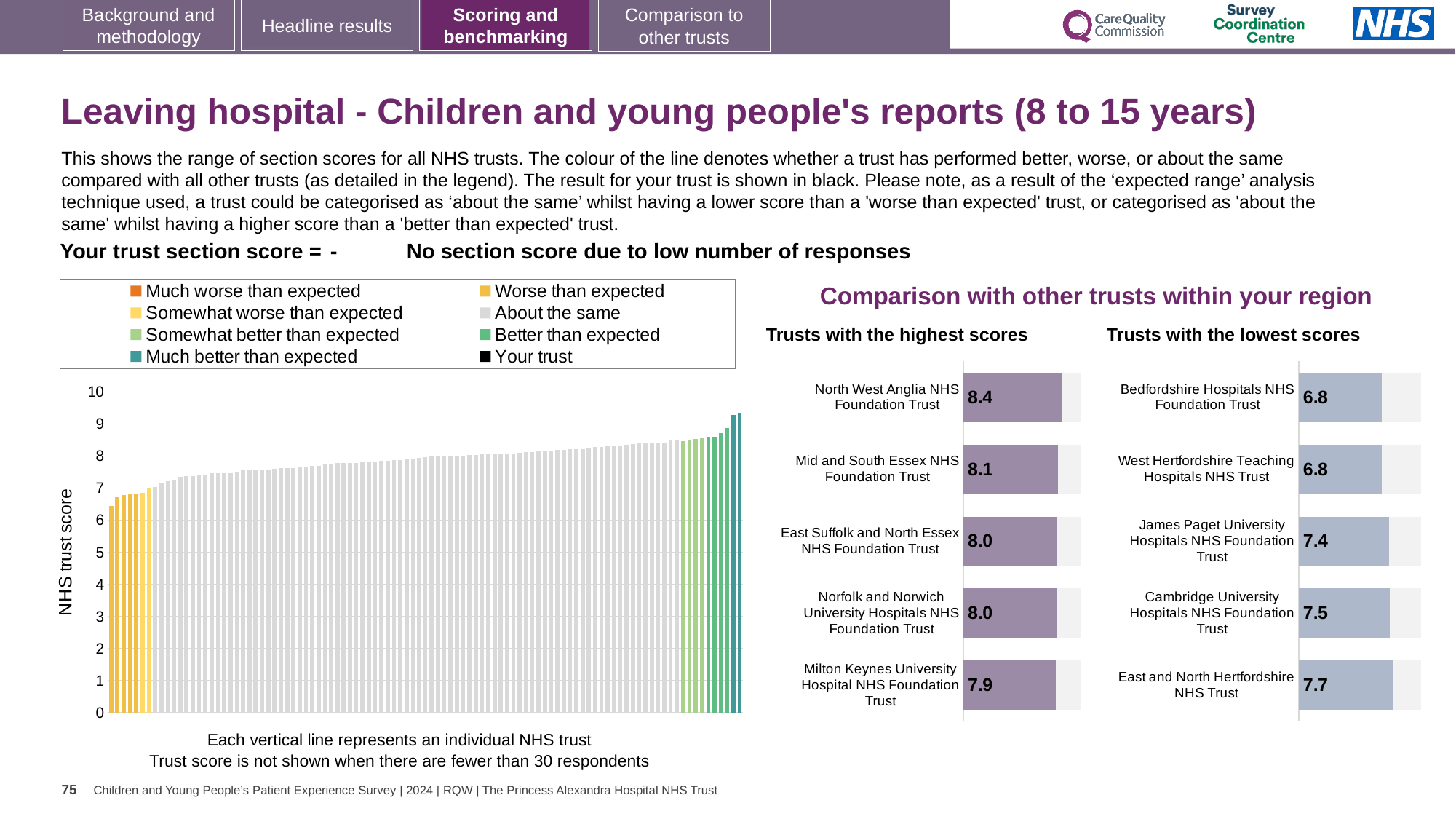
In the 'Trusts with the lowest scores' chart, what is the difference between the scores of East and North Hertfordshire NHS Trust and Bedfordshire Hospitals NHS Foundation Trust? 0.9 In the 'Trusts with the highest scores' chart, what is the score for North West Anglia NHS Foundation Trust? 8.4 In the large 'NHS trust score' chart on the left, do the values rise or fall from left to right? Rise In the 'Trusts with the highest scores' chart, which trust has the lowest score? Milton Keynes University Hospital NHS Foundation Trust In the 'Trusts with the lowest scores' chart, what is the score for James Paget University Hospitals NHS Foundation Trust? 7.4 How many trusts are shown in the 'Trusts with the lowest scores' chart? 5 In the 'Trusts with the highest scores' chart, what is the difference between the scores of North West Anglia NHS Foundation Trust and Milton Keynes University Hospital NHS Foundation Trust? 0.5 In the 'Trusts with the lowest scores' chart, which has the higher score: James Paget University Hospitals NHS Foundation Trust or Cambridge University Hospitals NHS Foundation Trust? Cambridge University Hospitals NHS Foundation Trust In the large 'NHS trust score' chart on the left, is the value of the leftmost bar greater or less than 7? less In the 'Trusts with the highest scores' chart, which trust has the highest score? North West Anglia NHS Foundation Trust What kind of chart is the large 'NHS trust score' chart on the left? Bar chart In the 'Trusts with the lowest scores' chart, which trust has the highest score? East and North Hertfordshire NHS Trust